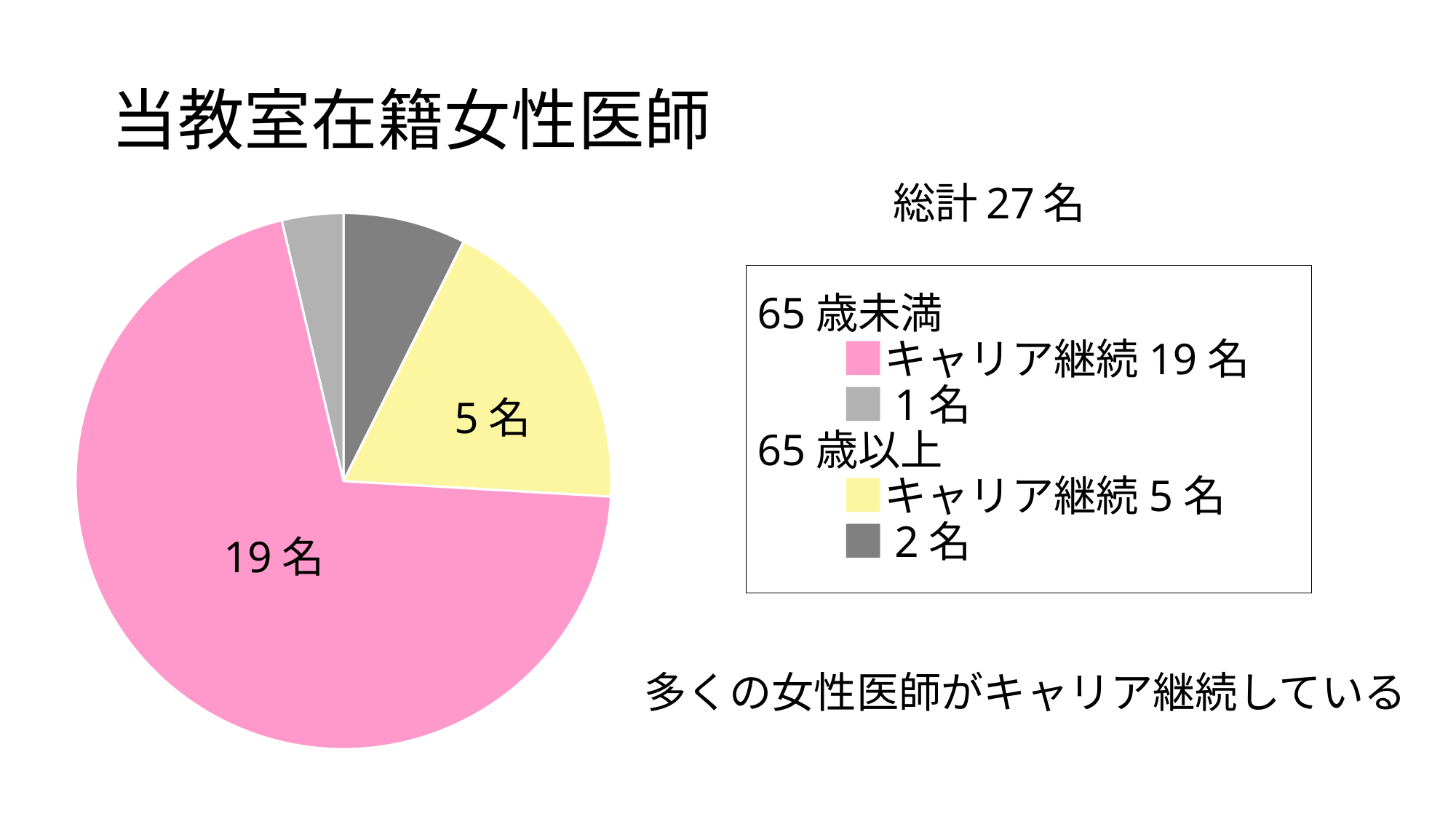
How many more doctors are in the 65歳未満 キャリア継続 group than in the 65歳以上 キャリア継続 group? 14名 How many slices does the pie chart have? 4 How many female doctors aged 65 and over (65歳以上) are continuing their careers (キャリア継続)? 5名 Which group is the smallest slice of the pie? 65歳未満 1名 (non-キャリア継続) Which group is the largest slice of the pie? 65歳未満 キャリア継続 Which colour represents the 65歳以上 キャリア継続 group in the pie chart? yellow According to the legend, how many doctors aged 65 and over (65歳以上) are not in the キャリア継続 group? 2名 What kind of chart is shown on the slide? pie chart How many female doctors under 65 (65歳未満) are continuing their careers (キャリア継続)? 19名 According to the legend, how many doctors under 65 (65歳未満) are not in the キャリア継続 group? 1名 What is the title of the slide's chart? 当教室在籍女性医師 What is the total number of female doctors shown (総計)? 27名